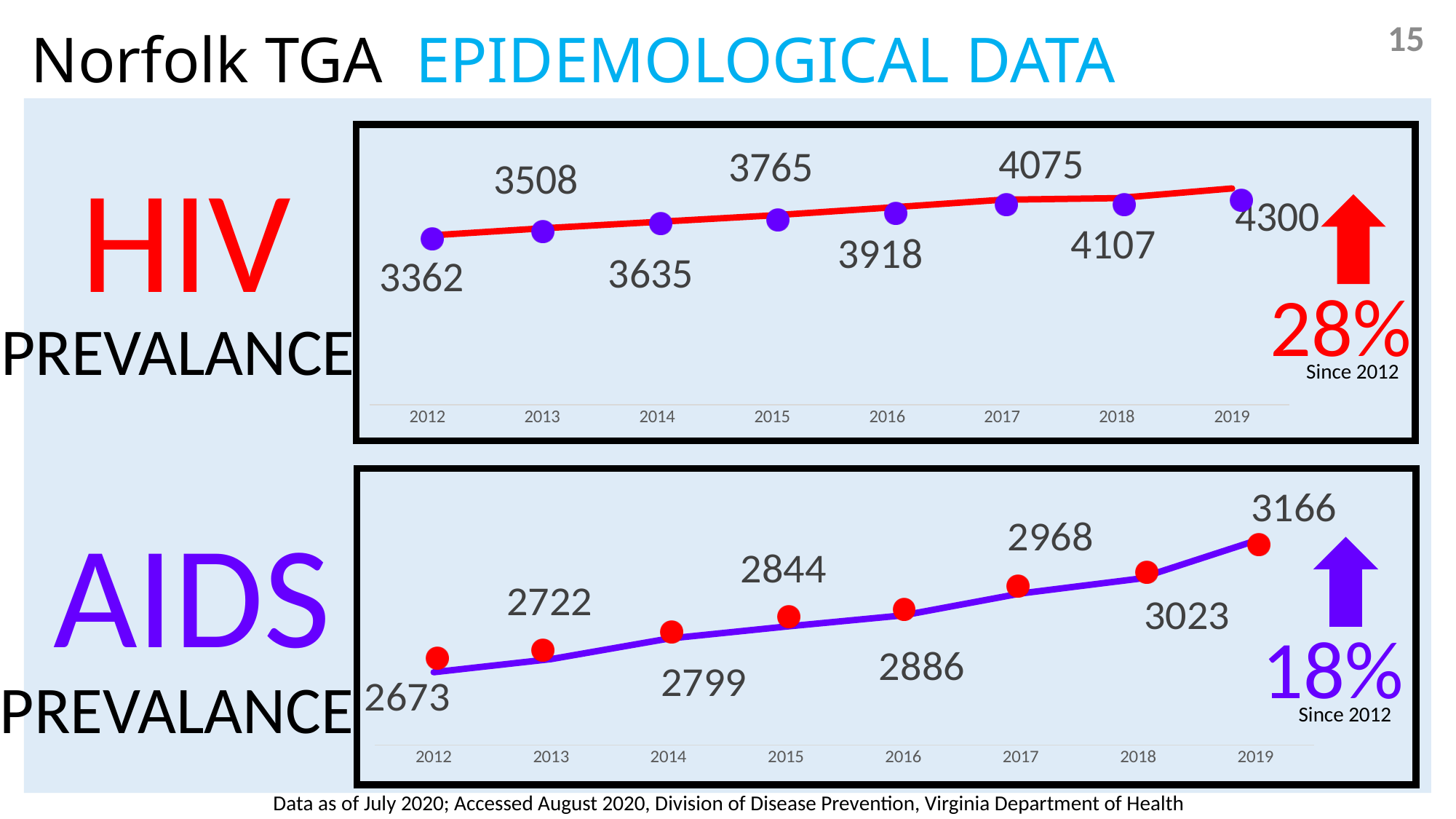
In the HIV prevalence chart, what is the difference between the 2019 and 2012 values? 938 What kind of chart is the HIV prevalence chart? line chart In the HIV prevalence chart, how many years are plotted? 8 In the AIDS prevalence chart, which is larger, the value for 2015 or the value for 2014? 2015 In the AIDS prevalence chart, which year has the lowest value? 2012 What percentage increase since 2012 is shown next to the AIDS prevalence chart? 18% In the HIV prevalence chart, what is the value for 2012? 3362 In the HIV prevalence chart, what is the value for 2019? 4300 In the HIV prevalence chart, which year has the highest value? 2019 In the HIV prevalence chart, do the values rise or fall from 2012 to 2019? rise In the AIDS prevalence chart, what is the difference between the 2018 and 2017 values? 55 In the AIDS prevalence chart, what is the value for 2016? 2886